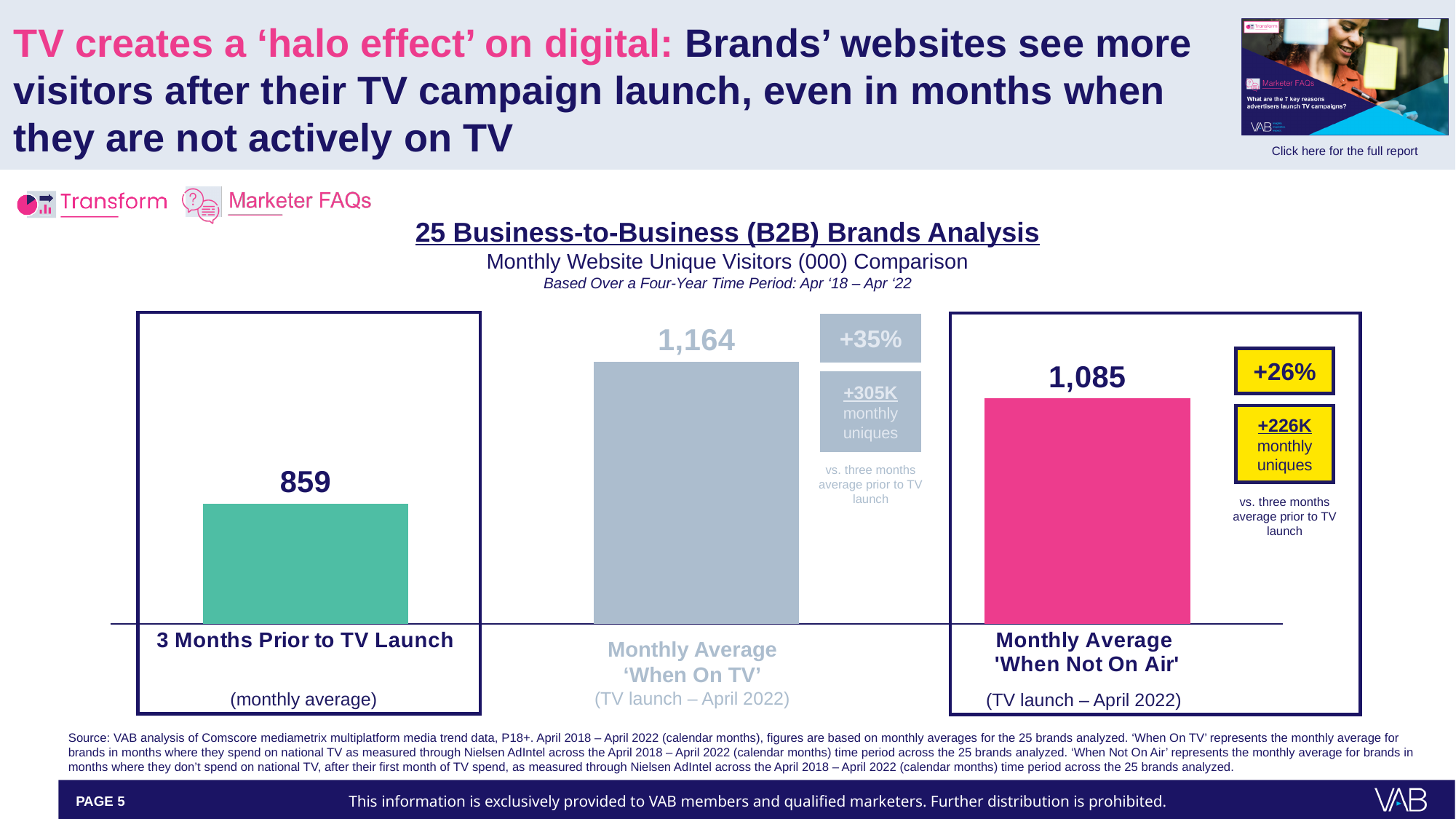
Which category has the lowest monthly website unique visitors? 3 Months Prior to TV Launch What is the difference between the 'When Not On Air' value and the 3 Months Prior to TV Launch value? 226 What is the monthly average of website unique visitors (000) for the 3 Months Prior to TV Launch? 859 What is the value for the Monthly Average 'When On TV' bar? 1,164 Which category has the highest monthly website unique visitors? Monthly Average 'When On TV' What is the title of the chart? 25 Business-to-Business (B2B) Brands Analysis How many bars are shown in the chart? 3 What is the difference between the 'When On TV' value and the 3 Months Prior to TV Launch value? 305 What is the value for the Monthly Average 'When Not On Air' bar? 1,085 What percentage increase is shown for the 'When Not On Air' monthly average versus the three months prior to TV launch? +26% Which is larger: the 'When On TV' value or the 'When Not On Air' value? When On TV What type of chart is shown on the slide? Bar chart